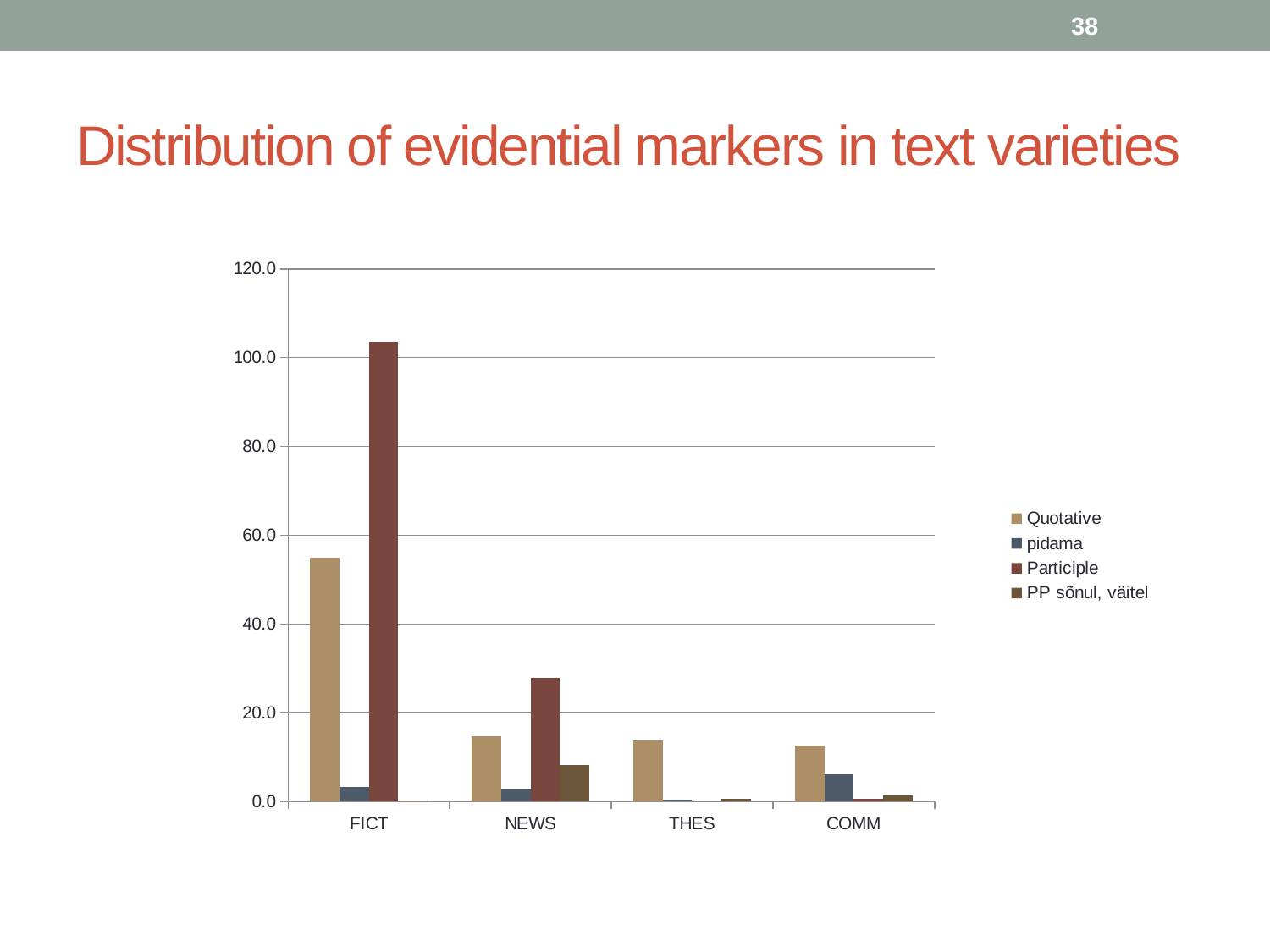
What kind of chart is shown on the slide? bar chart Is the Participle value for FICT greater or less than 100? greater Which series has the tallest bar for COMM? Quotative How many series does the legend list? 4 For FICT, which is larger: the Quotative value or the Participle value? Participle Is the Quotative value for FICT greater or less than 60? less Which text variety has the highest Participle value? FICT What is the title of the chart slide? Distribution of evidential markers in text varieties Do the Quotative values rise or fall from FICT to COMM along the x axis? fall Is the Quotative value for NEWS greater or less than 20? less How many text variety categories are shown on the x axis? 4